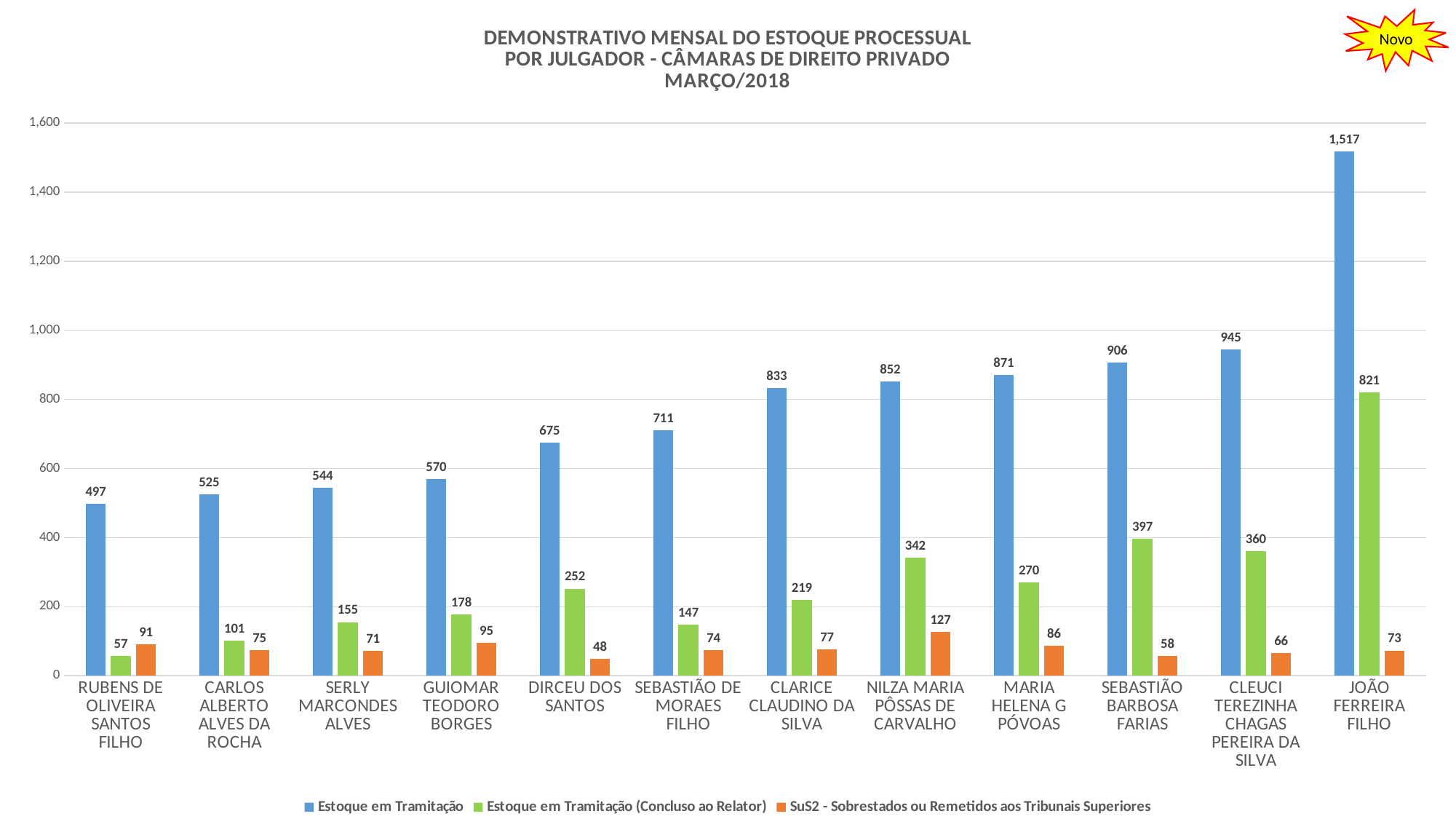
What is the 'SuS2 - Sobrestados ou Remetidos aos Tribunais Superiores' value for DIRCEU DOS SANTOS? 48 What is the 'Estoque em Tramitação (Concluso ao Relator)' value for NILZA MARIA PÔSSAS DE CARVALHO? 342 Do the 'Estoque em Tramitação' values rise or fall from left to right along the x axis? rise Which judge has the highest 'Estoque em Tramitação' value? JOÃO FERREIRA FILHO What is the difference between the 'Estoque em Tramitação' values of CLEUCI TEREZINHA CHAGAS PEREIRA DA SILVA and SEBASTIÃO BARBOSA FARIAS? 39 How many judges are shown on the x axis? 12 Which judge has the lowest 'Estoque em Tramitação (Concluso ao Relator)' value? RUBENS DE OLIVEIRA SANTOS FILHO Which is larger: the 'SuS2' value for RUBENS DE OLIVEIRA SANTOS FILHO or for MARIA HELENA G PÓVOAS? RUBENS DE OLIVEIRA SANTOS FILHO How many series does the legend list? 3 What is the 'Estoque em Tramitação' value for JOÃO FERREIRA FILHO? 1,517 Is the 'Estoque em Tramitação' value for CLARICE CLAUDINO DA SILVA greater or less than 800? greater What kind of chart is shown on the slide? bar chart